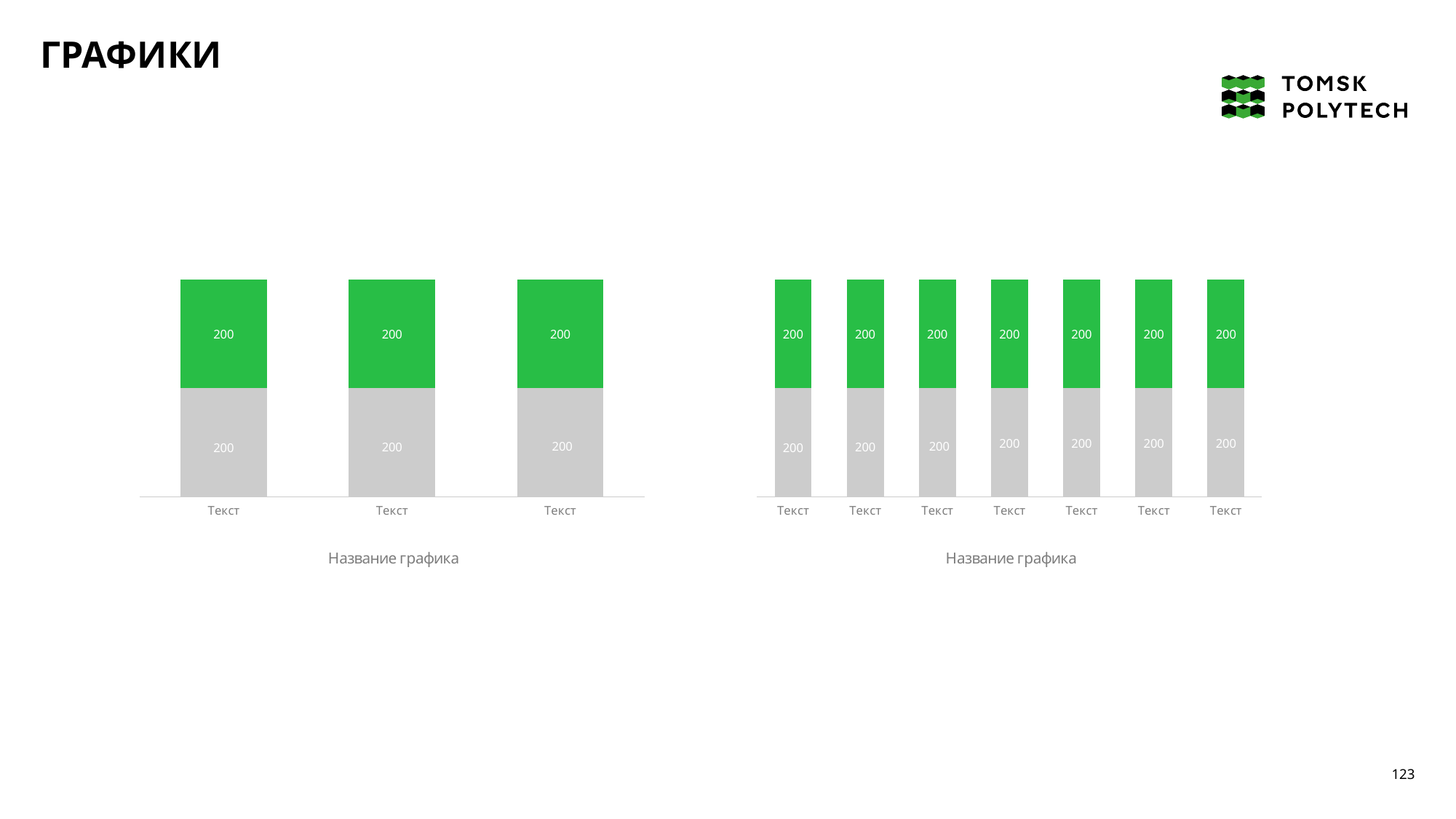
In the right chart, do the bar totals rise, fall, or stay flat from left to right? stay flat What kind of chart is the left chart on the slide? stacked bar chart In the right chart, what is the value of the green segment of the last bar? 200 In the left chart, what is the value of the green segment of the first bar? 200 How many bars does the left chart have? 3 How many bars does the right chart have? 7 What category label is shown under each bar in the right chart? Текст In the right chart, what is the total of the fourth stacked bar? 400 What kind of chart is the right chart on the slide? stacked bar chart In the left chart, what is the total of the first stacked bar? 400 In the left chart, what is the value of the grey segment of the third bar? 200 What is the title shown under the left chart? Название графика